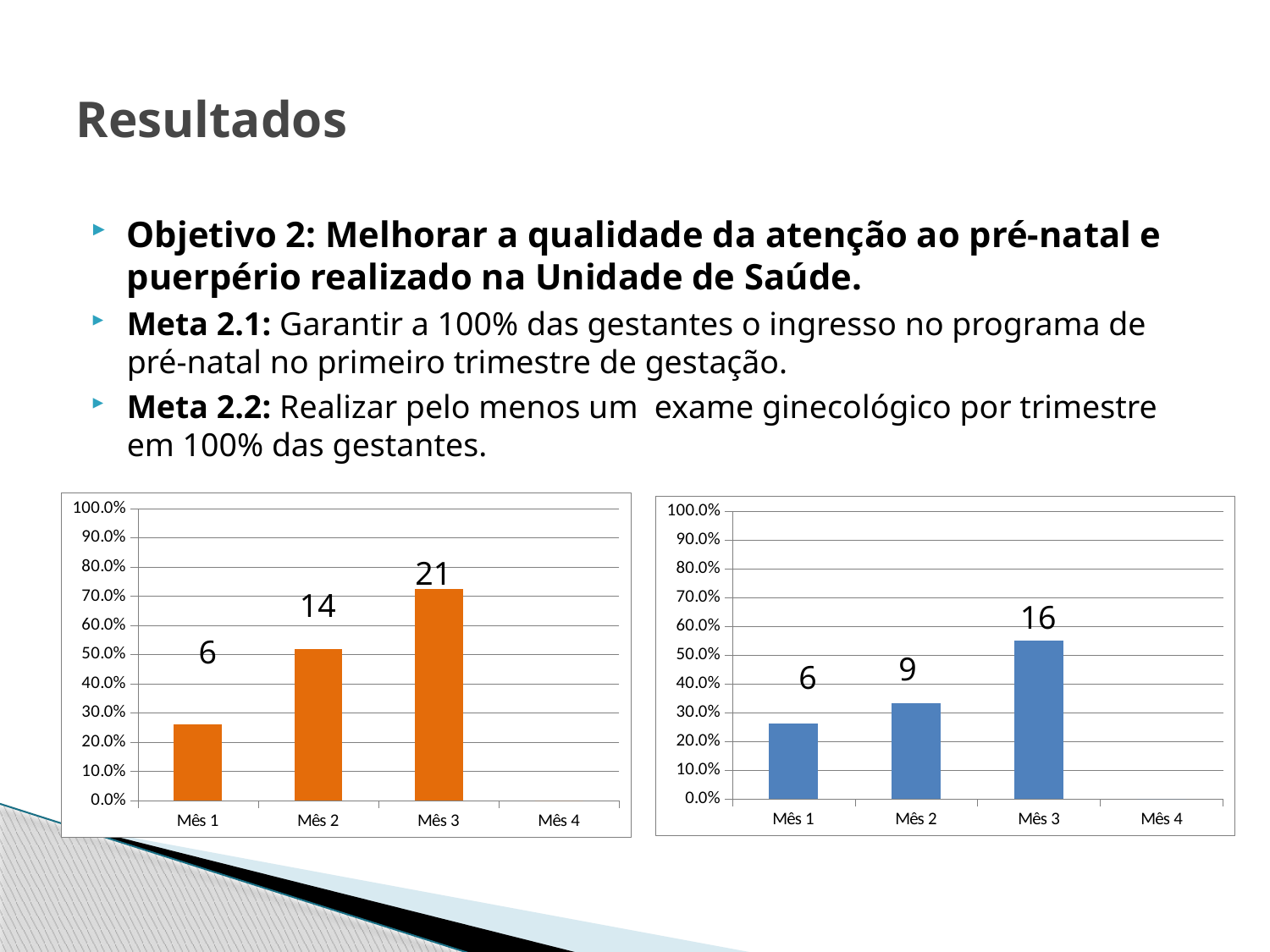
In the left chart (orange bars), what is the data label shown for Mês 2? 14 How many month categories are shown on the x axis of the left chart? 4 In the left chart (orange bars), what is the data label shown for Mês 3? 21 What kind of chart is the right chart? bar chart Comparing the data labels for Mês 2, which chart shows the larger value, the left (orange) chart or the right (blue) chart? the left (orange) chart In the right chart (blue bars), is the bar for Mês 1 greater or less than 30.0%? less In the left chart (orange bars), what is the difference between the data labels for Mês 3 and Mês 1? 15 In the right chart (blue bars), which month with a bar has the lowest value? Mês 1 In the right chart (blue bars), what is the difference between the data labels for Mês 3 and Mês 2? 7 In the right chart (blue bars), what is the data label shown for Mês 2? 9 In the left chart (orange bars), which month has the highest bar? Mês 3 In the right chart (blue bars), what is the data label shown for Mês 3? 16